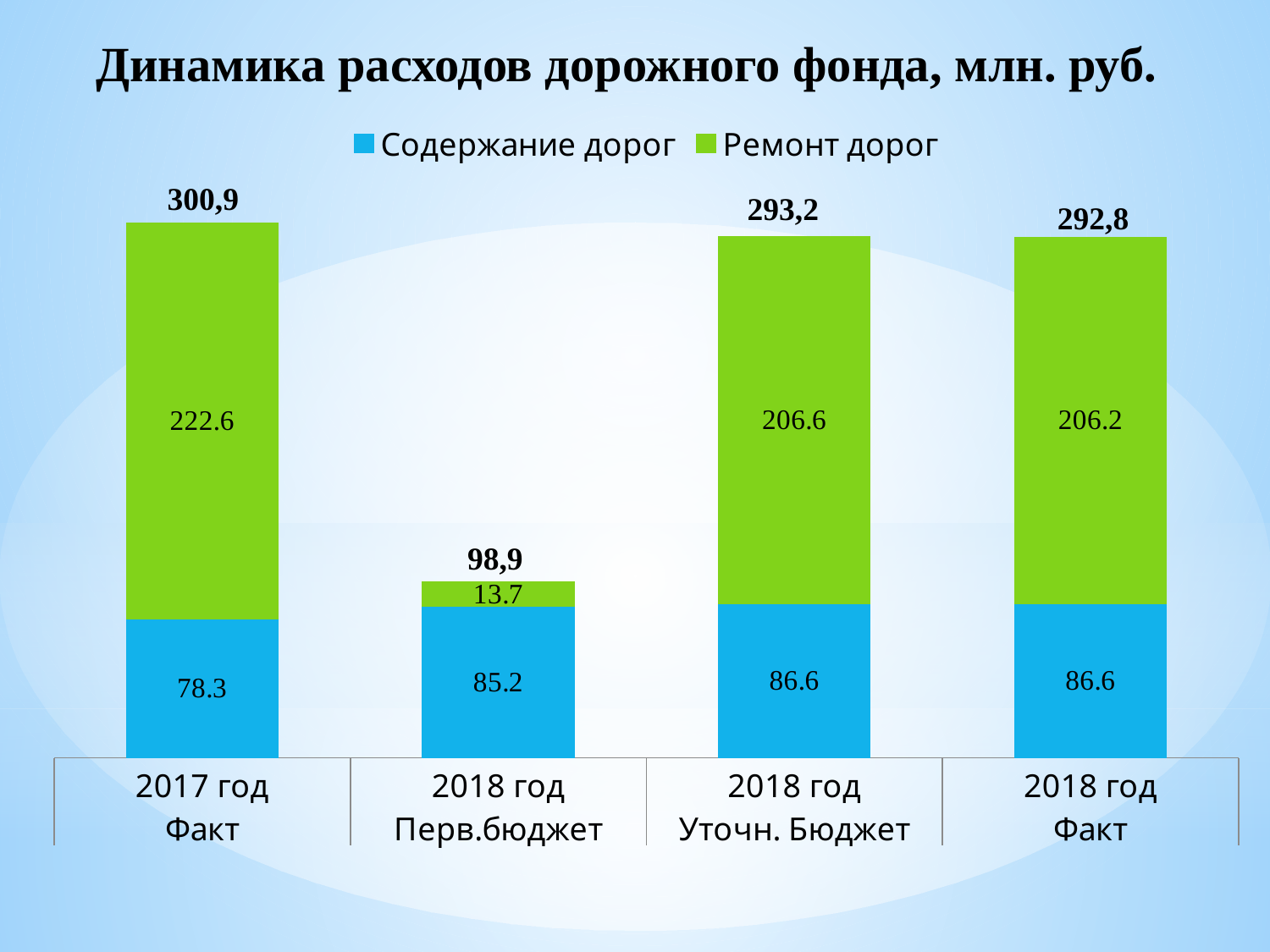
How many series does the legend list? 2 What kind of chart is shown on the slide? Stacked bar chart How many categories are shown on the x axis? 4 Which category has the highest total? 2017 год Факт Which category has the lowest value for Ремонт дорог? 2018 год Перв.бюджет What is the title of the chart? Динамика расходов дорожного фонда, млн. руб. What is the value of Содержание дорог for 2017 год Факт? 78.3 Which is larger: Содержание дорог for 2017 год Факт or for 2018 год Перв.бюджет? 2018 год Перв.бюджет What is the total of the stacked bar for 2018 год Факт? 292,8 What is the difference between Ремонт дорог for 2017 год Факт and for 2018 год Факт? 16.4 What is the value of Ремонт дорог for 2018 год Уточн. Бюджет? 206.6 What is the value of Ремонт дорог for 2018 год Перв.бюджет? 13.7